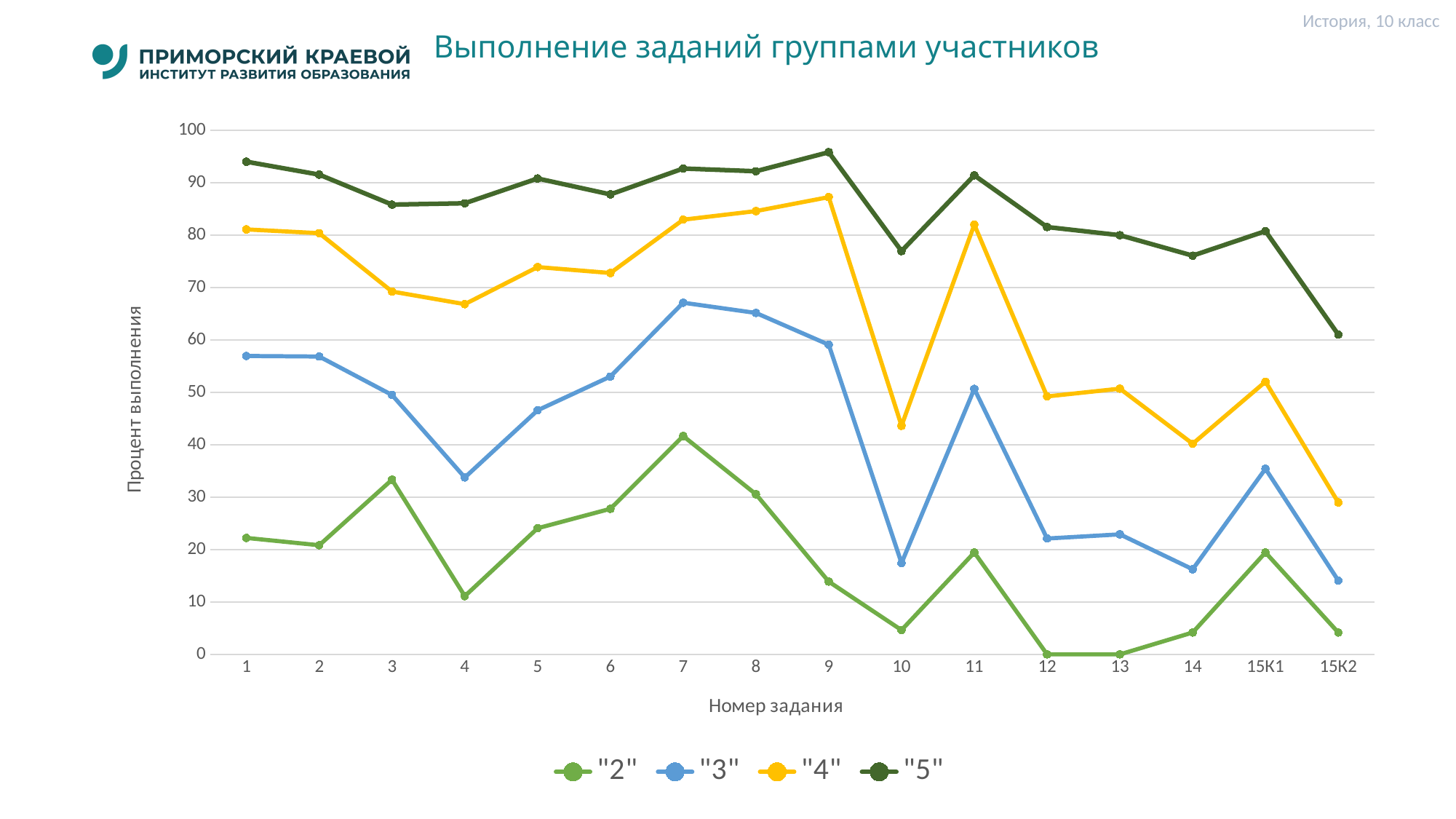
How many task numbers are shown along the x axis? 16 What is the title of the vertical axis? Процент выполнения At which task number does series "5" have its lowest value? 15К2 At which task number does series "5" reach its highest value? 9 How many series does the legend list? 4 Is the value for series "4" at task 10 greater or less than 50? less Is the value for series "2" at task 4 greater or less than 20? less What kind of chart is shown on the slide? line chart What is the value for series "2" at task 12? 0 Is the value for series "3" at task 7 greater or less than 60? greater At task 10, which series has the larger value, "4" or "5"? "5"